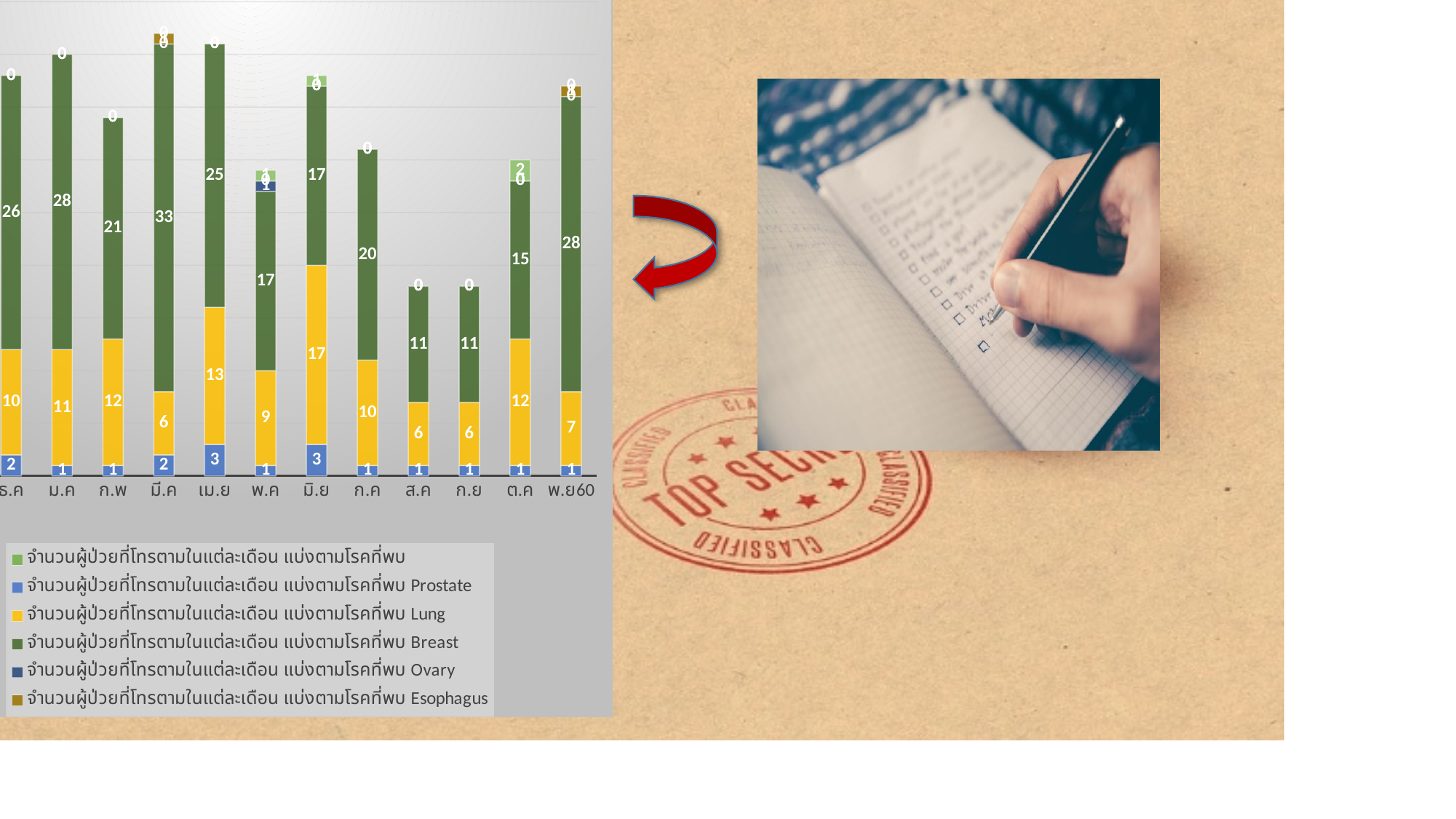
Which is larger, the Lung value for ก.พ or the Lung value for มี.ค? ก.พ How many series does the legend list? 6 What is the Lung value for มิ.ย? 17 How many months (categories) are shown on the x axis? 12 What is the Breast value for มี.ค? 33 What is the difference between the Breast values for มี.ค and ส.ค? 22 What is the Breast value for พ.ย60? 28 Which month has the highest Lung value? มิ.ย Which month has the highest Breast value? มี.ค Which series in the legend is shown in yellow? Lung What is the Prostate value for เม.ย? 3 What kind of chart is shown on the slide? stacked bar chart